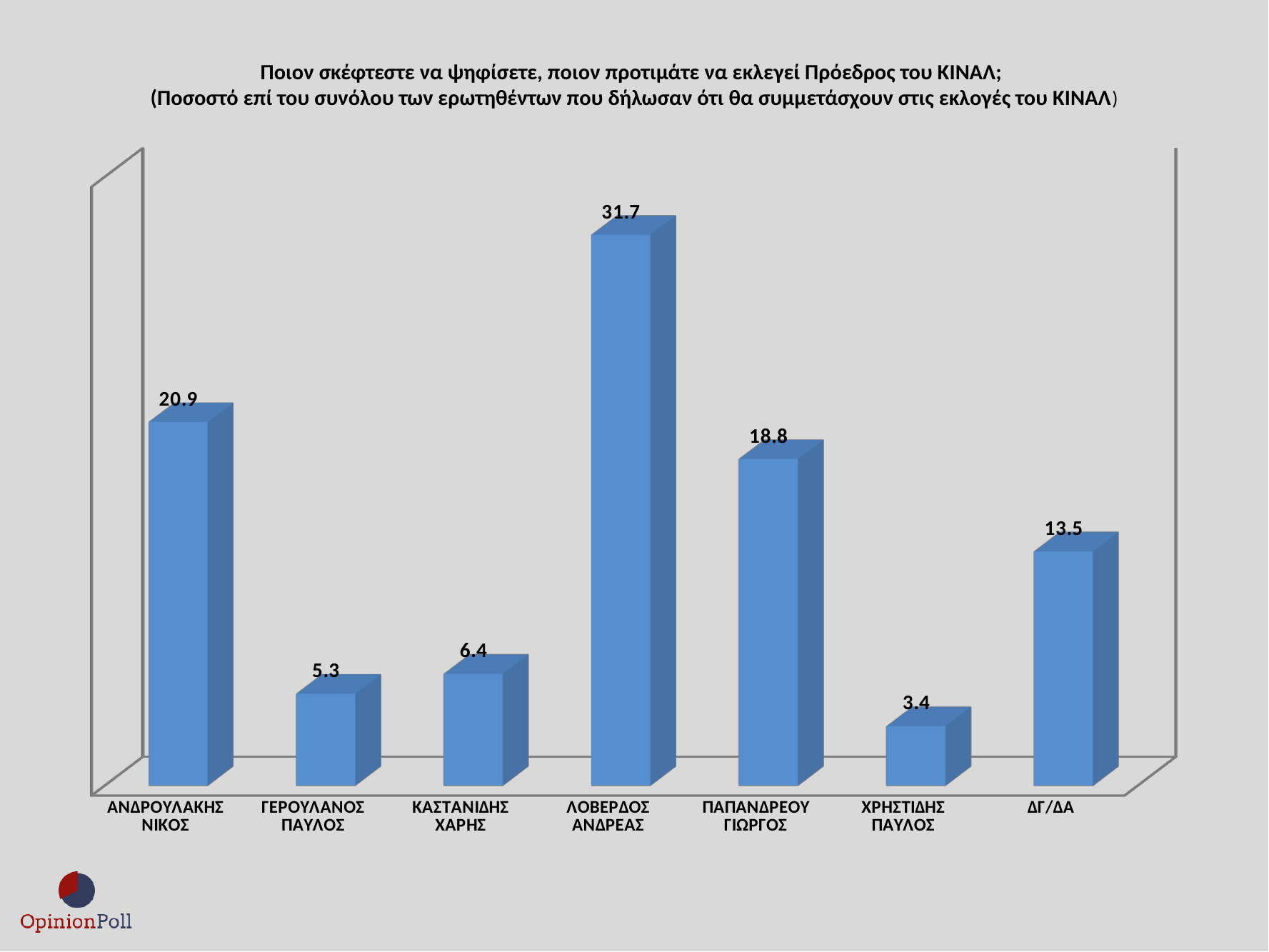
What colour are the bars in the chart? Blue Which is larger, the value for ΠΑΠΑΝΔΡΕΟΥ ΓΙΩΡΓΟΣ or the value for ΔΓ/ΔΑ? ΠΑΠΑΝΔΡΕΟΥ ΓΙΩΡΓΟΣ Which category has the lowest value? ΧΡΗΣΤΙΔΗΣ ΠΑΥΛΟΣ What is the value for ΔΓ/ΔΑ? 13.5 What is the value for ΧΡΗΣΤΙΔΗΣ ΠΑΥΛΟΣ? 3.4 What is the value for ΑΝΔΡΟΥΛΑΚΗΣ ΝΙΚΟΣ? 20.9 How many categories are shown on the chart? 7 What is the difference between the values for ΛΟΒΕΡΔΟΣ ΑΝΔΡΕΑΣ and ΑΝΔΡΟΥΛΑΚΗΣ ΝΙΚΟΣ? 10.8 Which category has the highest value? ΛΟΒΕΡΔΟΣ ΑΝΔΡΕΑΣ What kind of chart is shown on the slide? Bar chart What is the value for ΛΟΒΕΡΔΟΣ ΑΝΔΡΕΑΣ? 31.7 What is the difference between the values for ΚΑΣΤΑΝΙΔΗΣ ΧΑΡΗΣ and ΓΕΡΟΥΛΑΝΟΣ ΠΑΥΛΟΣ? 1.1